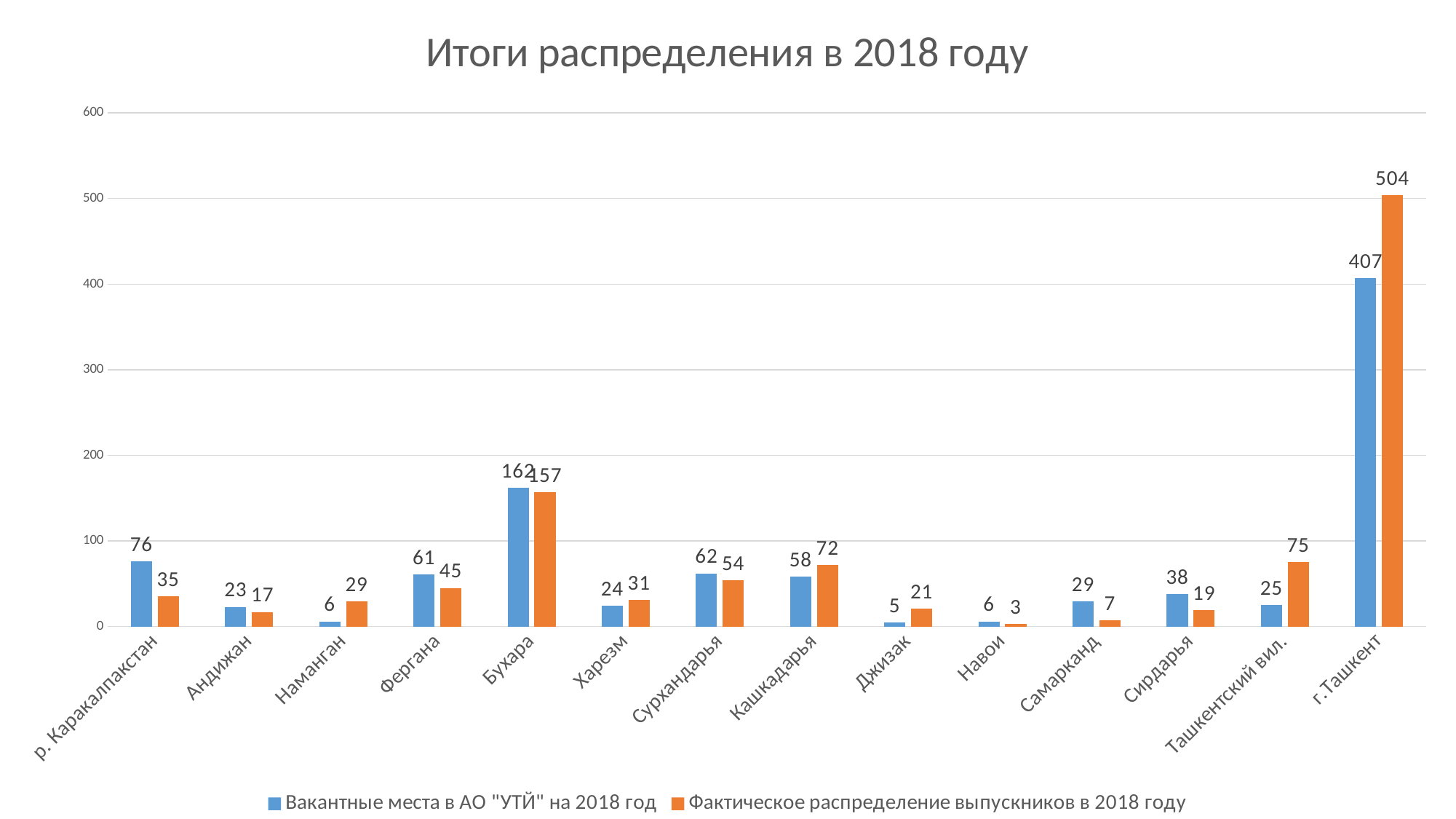
Is the value of "Вакантные места в АО "УТЙ" на 2018 год" for Бухара greater or less than 100? greater What type of chart is shown on the slide? Bar chart How many categories are shown on the x axis? 14 What is the value of "Фактическое распределение выпускников в 2018 году" for Кашкадарья? 72 Which category has the lowest value for "Фактическое распределение выпускников в 2018 году"? Навои What is the difference between the two series for г.Ташкент? 97 What is the value of "Фактическое распределение выпускников в 2018 году" for Ташкентский вил.? 75 For Самарканд, which series has the larger value? Вакантные места в АО "УТЙ" на 2018 год What is the difference between the two series for р. Каракалпакстан? 41 Which category has the highest value for "Фактическое распределение выпускников в 2018 году"? г.Ташкент How many series does the legend list? 2 What is the value of "Вакантные места в АО "УТЙ" на 2018 год" for г.Ташкент? 407